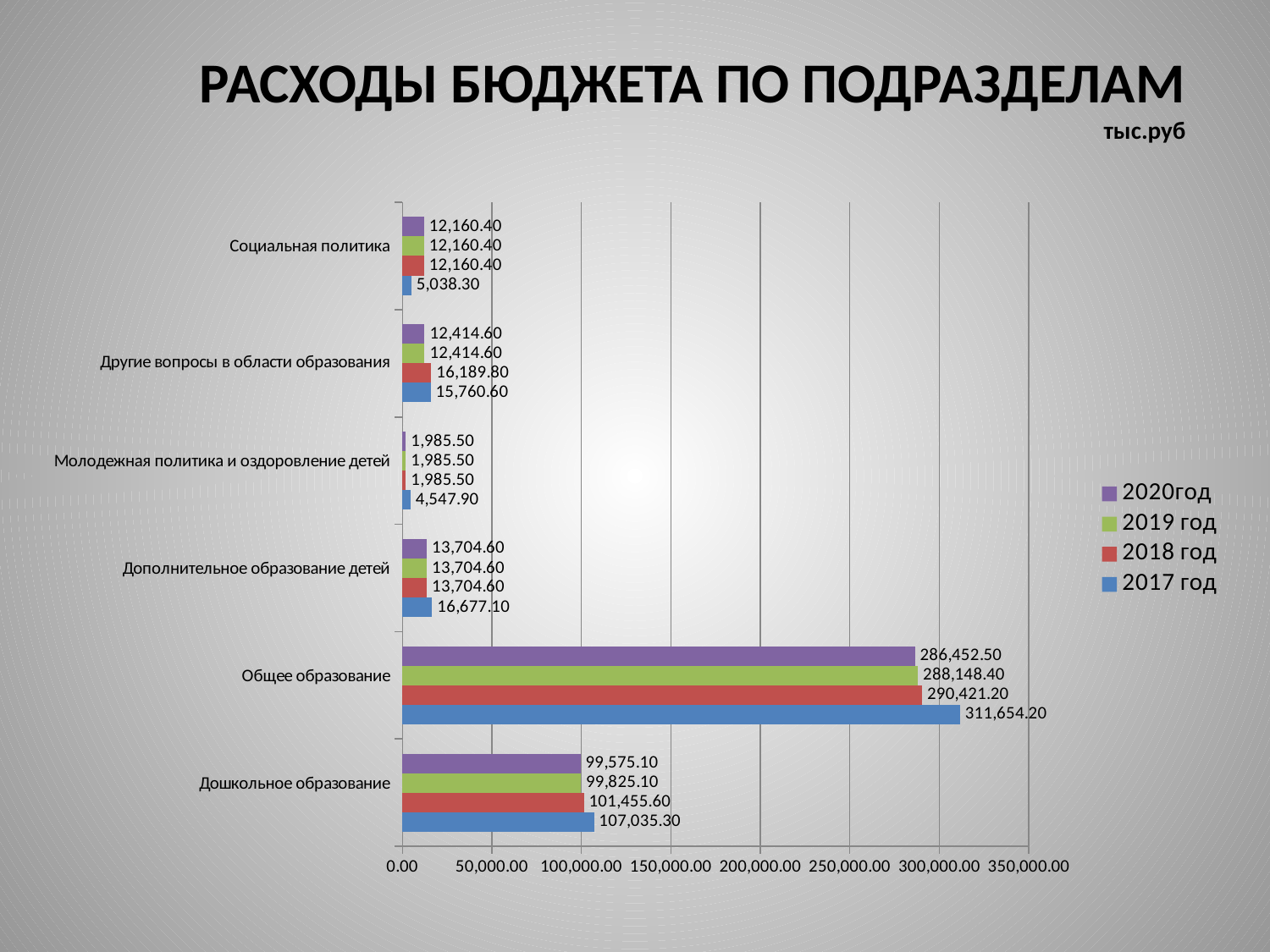
In the 2017 год series, which is larger: Социальная политика or Молодежная политика и оздоровление детей? Социальная политика How many series does the legend list? 4 What is the difference between the 2017 год and 2020год values for Общее образование? 25,201.70 What is the value for Общее образование in the 2017 год series? 311,654.20 What is the value for Другие вопросы в области образования in the 2018 год series? 16,189.80 What is the value for Дошкольное образование in the 2020год series? 99,575.10 What is the difference between the 2018 год and 2019 год values for Дошкольное образование? 1,630.50 Is the 2017 год value for Дошкольное образование greater or less than 100,000.00? greater What kind of chart is shown on the slide? bar chart Which category has the lowest value in the 2017 год series? Молодежная политика и оздоровление детей How many categories are shown on the chart? 6 Which category has the highest value in the 2018 год series? Общее образование